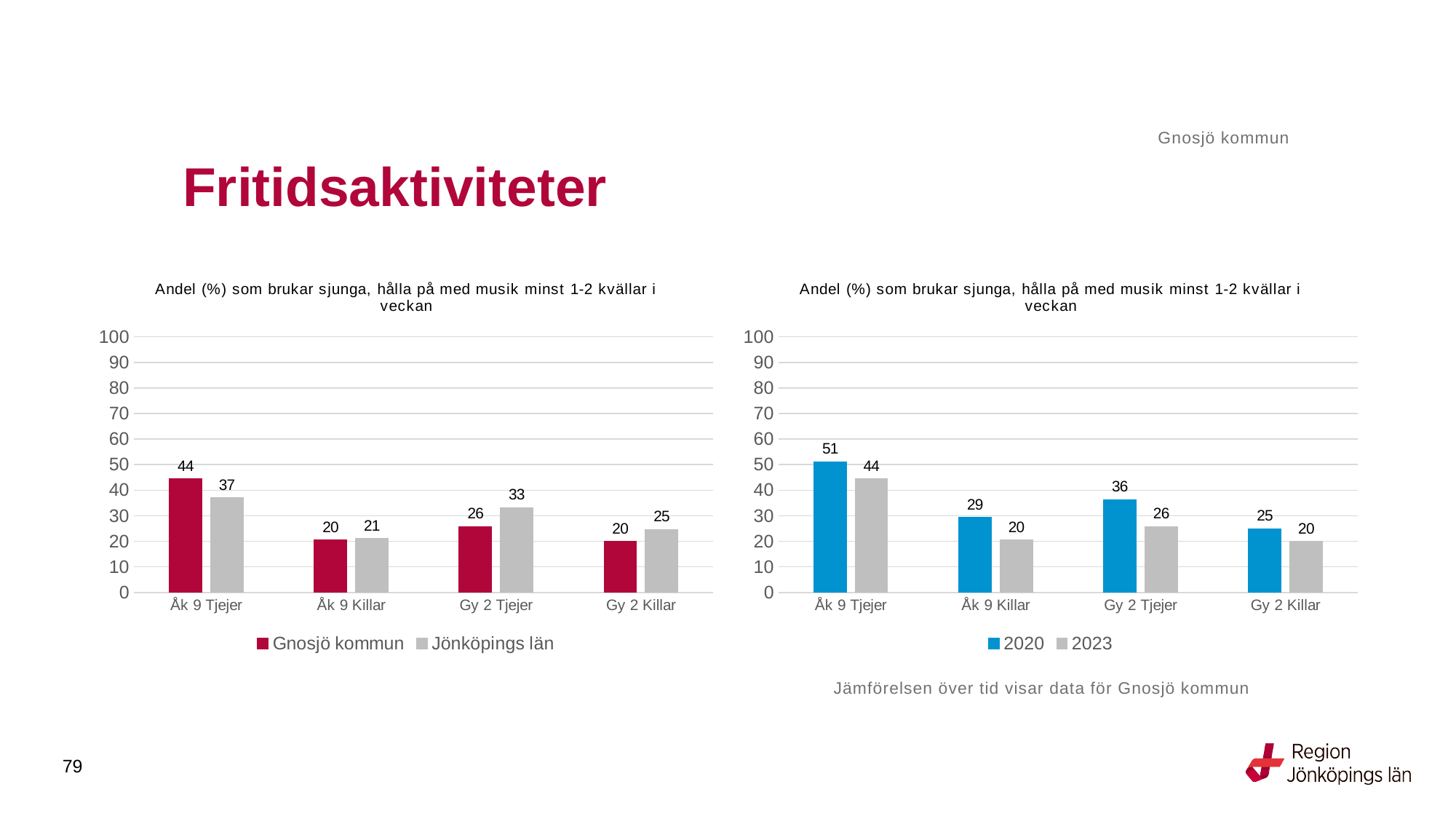
In the right chart, what is the difference between the 2020 and 2023 values for Åk 9 Tjejer? 7 In the right chart, what is the 2020 value for Åk 9 Killar? 29 In the left chart, which is larger for Gy 2 Killar: Gnosjö kommun or Jönköpings län? Jönköpings län In the right chart, what is the 2023 value for Gy 2 Killar? 20 How many series does the legend of the left chart list? 2 In the left chart, what is the difference between the Gnosjö kommun and Jönköpings län values for Gy 2 Tjejer? 7 How many categories are shown on the x axis of the right chart? 4 In the right chart, which category has the highest 2020 value? Åk 9 Tjejer In the left chart, what is the value for Jönköpings län for Gy 2 Tjejer? 33 In the left chart, which category has the lowest Jönköpings län value? Åk 9 Killar In the left chart, what is the value for Gnosjö kommun for Åk 9 Tjejer? 44 What type of chart is the right chart? Bar chart